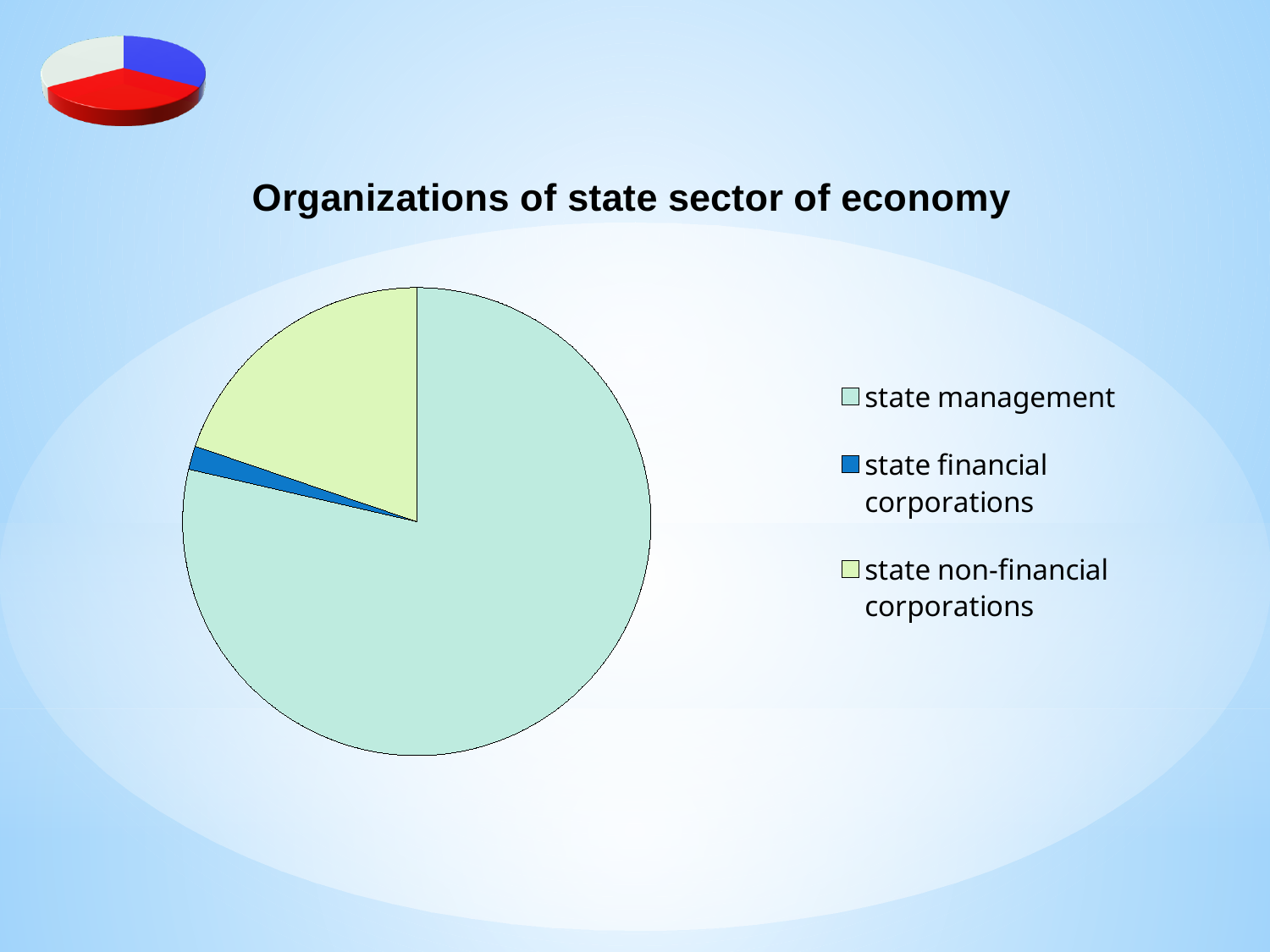
Which category has the largest slice of the pie? state management How many entries does the legend list? 3 Which category has the smallest slice of the pie? state financial corporations Which slice is larger: state management or state non-financial corporations? state management How many slices does the pie chart have? 3 Which slice is larger: state financial corporations or state non-financial corporations? state non-financial corporations What kind of chart is shown on the slide? pie chart Which category is shown in blue in the pie chart? state financial corporations Does the state management slice take up more or less than half of the pie? more What is the title of the chart? Organizations of state sector of economy